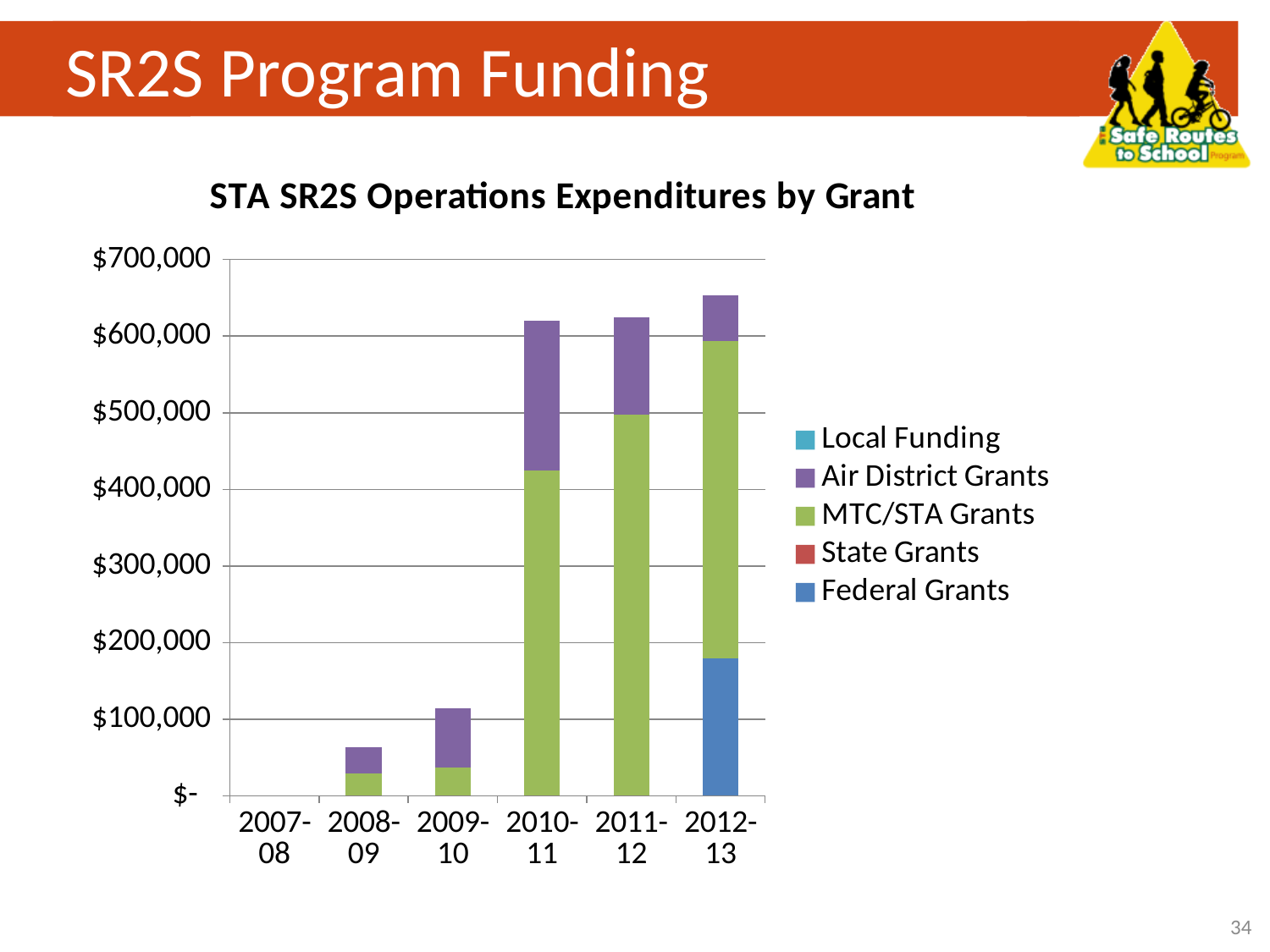
What kind of chart is shown on the slide? Stacked bar chart Do total expenditures generally rise or fall from 2007-08 to 2012-13? rise How many series does the legend list? 5 Is the Federal Grants value for 2012-13 greater or less than $200,000? less Is the total expenditure for 2008-09 greater or less than $100,000? less Is the total expenditure for 2010-11 greater or less than $600,000? greater What is the title of the chart? STA SR2S Operations Expenditures by Grant Which has the larger total expenditure, 2009-10 or 2010-11? 2010-11 Which fiscal year has the highest total expenditures? 2012-13 How many fiscal year categories are shown on the x axis? 6 Which fiscal year has the lowest total expenditures? 2007-08 Which is the only fiscal year that shows Federal Grants expenditures? 2012-13